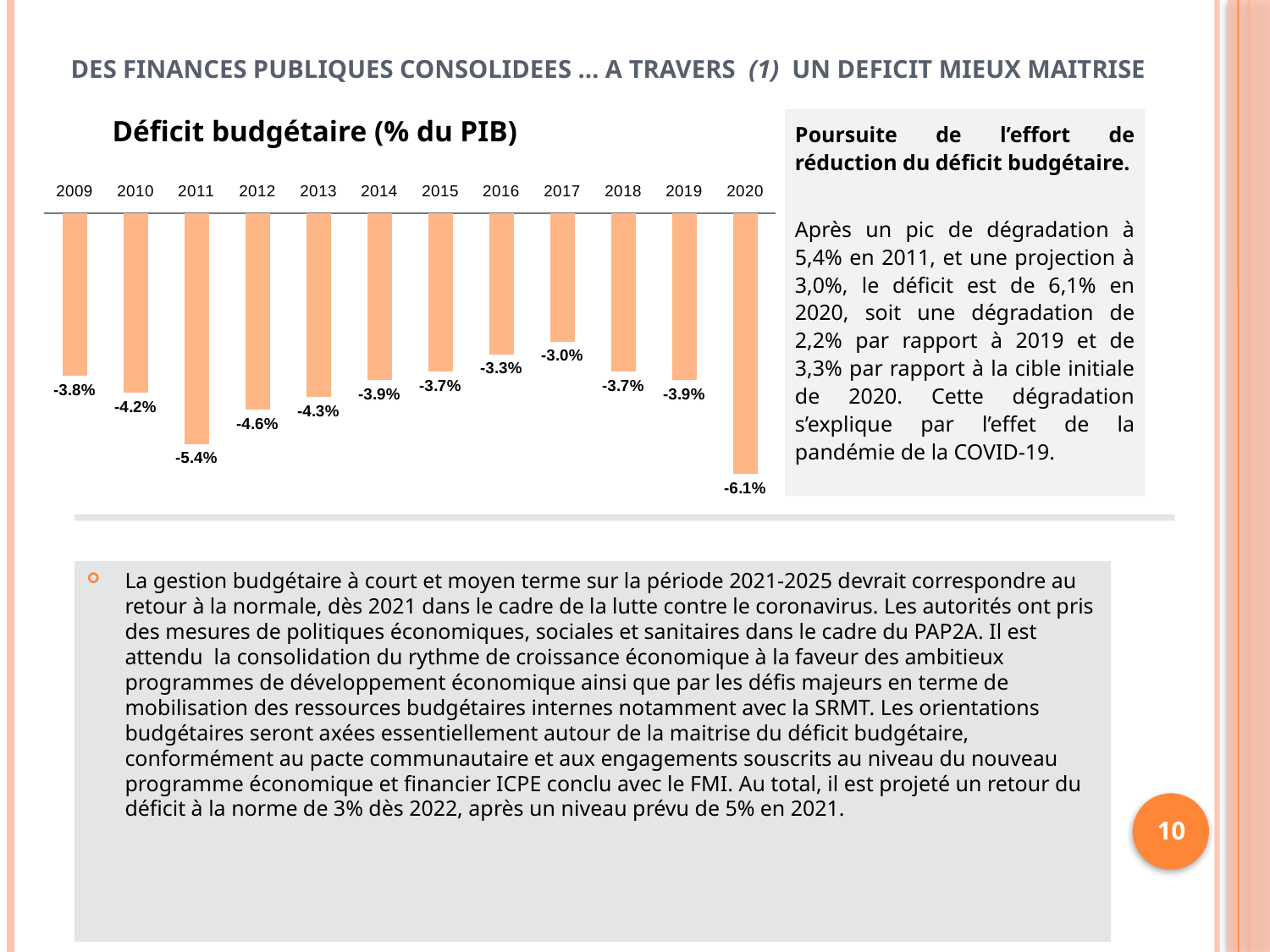
What is the value for 2017 in the Déficit budgétaire (% du PIB) chart? -3.0% Which year has the smallest deficit (the highest value) in the Déficit budgétaire (% du PIB) chart? 2017 In the Déficit budgétaire (% du PIB) chart, does the deficit shrink or grow from 2011 to 2017? Shrink What is the value for 2009 in the Déficit budgétaire (% du PIB) chart? -3.8% What is the value for 2011 in the Déficit budgétaire (% du PIB) chart? -5.4% In the Déficit budgétaire (% du PIB) chart, which year has the larger deficit, 2012 or 2013? 2012 How many years are shown in the Déficit budgétaire (% du PIB) chart? 12 What kind of chart is the Déficit budgétaire (% du PIB) chart? Bar chart By how many percentage points does the deficit in 2020 differ from the deficit in 2019 in the Déficit budgétaire (% du PIB) chart? 2.2 percentage points What is the value for 2020 in the Déficit budgétaire (% du PIB) chart? -6.1% By how many percentage points does the deficit in 2011 differ from the deficit in 2009 in the Déficit budgétaire (% du PIB) chart? 1.6 percentage points Which year has the largest deficit (the lowest value) in the Déficit budgétaire (% du PIB) chart? 2020